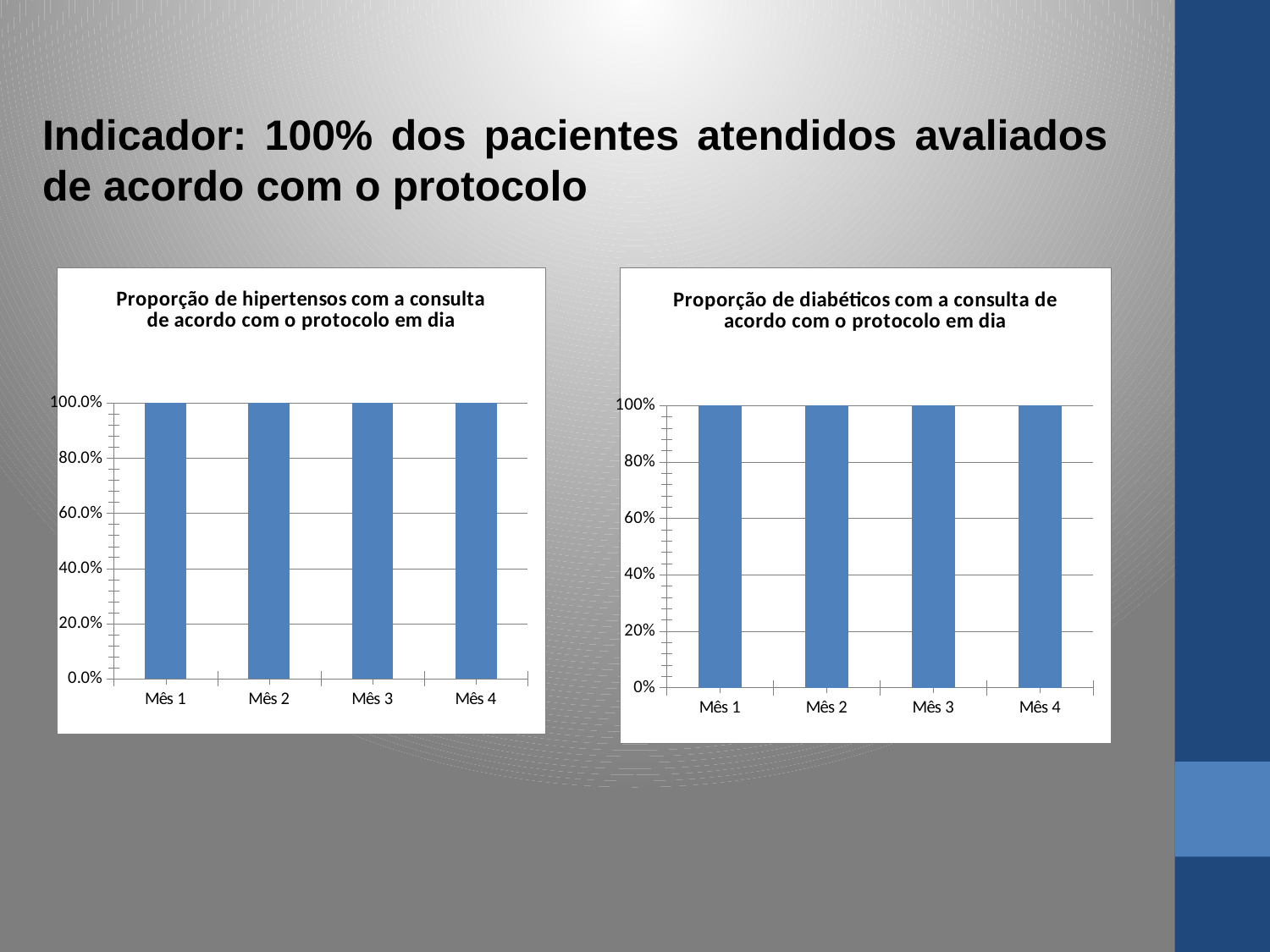
What is the title of the right chart? Proporção de diabéticos com a consulta de acordo com o protocolo em dia In the right chart (Proporção de diabéticos), what is the value for Mês 2? 100% In the right chart (Proporção de diabéticos), do the values rise, fall or stay flat from Mês 1 to Mês 4? stay flat What kind of chart is the left chart (Proporção de hipertensos)? bar chart In the left chart (Proporção de hipertensos), is the value for Mês 2 greater or less than 80.0%? greater In the right chart (Proporção de diabéticos), what is the value for Mês 3? 100% In the left chart (Proporção de hipertensos), what is the value for Mês 4? 100.0% How many bars are plotted in the right chart (Proporção de diabéticos)? 4 In the left chart (Proporção de hipertensos), what is the value for Mês 1? 100.0% In the left chart (Proporção de hipertensos), what is the difference between the values for Mês 1 and Mês 3? 0.0% In the right chart (Proporção de diabéticos), is the value for Mês 4 greater or less than 60%? greater How many categories (months) are shown in the left chart (Proporção de hipertensos)? 4